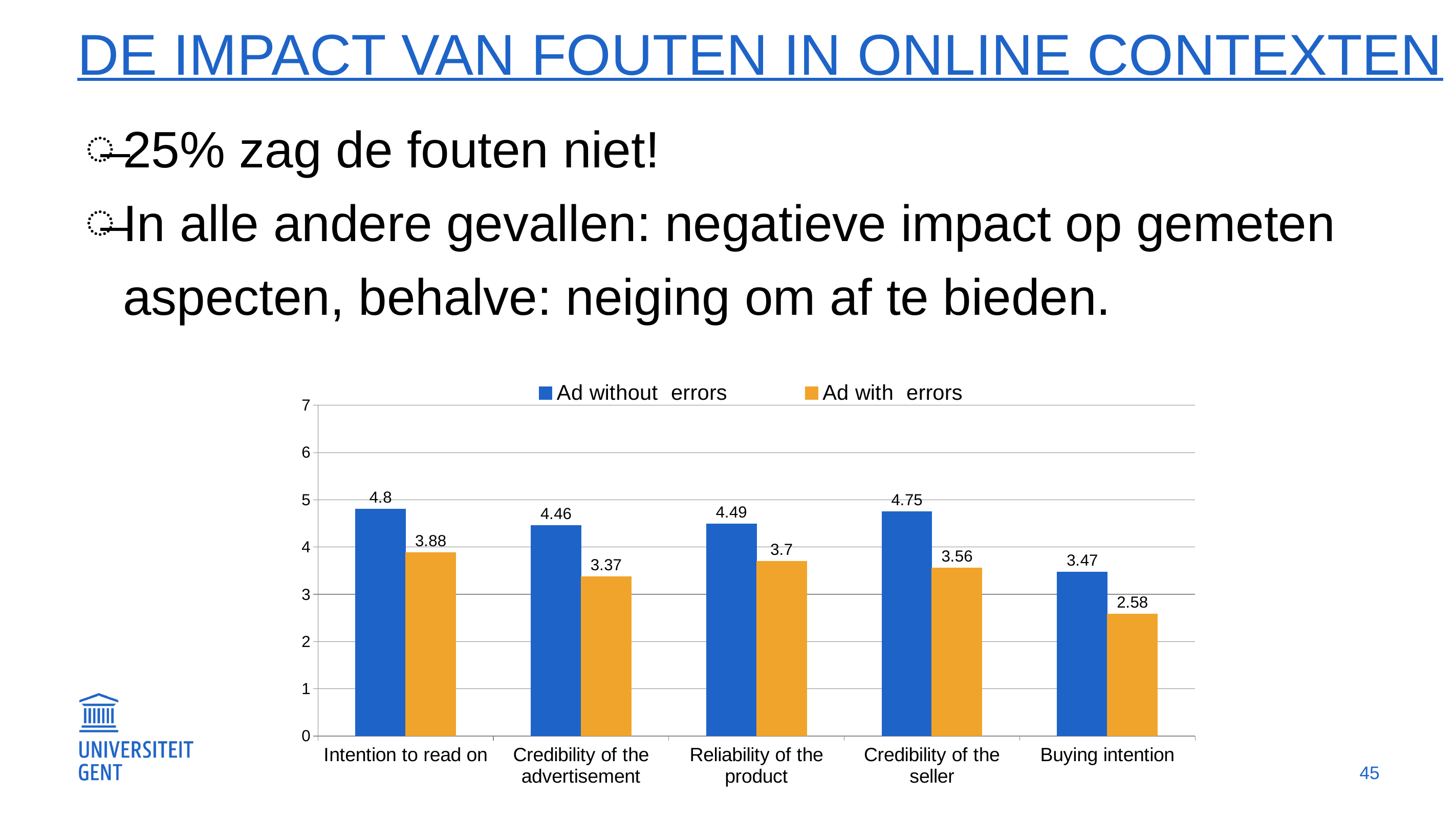
What kind of chart is shown on the slide? bar chart Which is larger for Reliability of the product: 'Ad without errors' or 'Ad with errors'? Ad without errors What is the value for 'Ad with errors' for Buying intention? 2.58 What is the value for 'Ad without errors' for Intention to read on? 4.8 How many categories are shown on the x axis? 5 Which category has the highest value for 'Ad without errors'? Intention to read on Is the value for 'Ad with errors' for Intention to read on greater or less than 4? less What is the difference between 'Ad without errors' and 'Ad with errors' for Credibility of the seller? 1.19 What is the value for 'Ad with errors' for Credibility of the advertisement? 3.37 What is the difference between 'Ad without errors' and 'Ad with errors' for Buying intention? 0.89 How many series does the legend list? 2 Which category has the lowest value for 'Ad with errors'? Buying intention